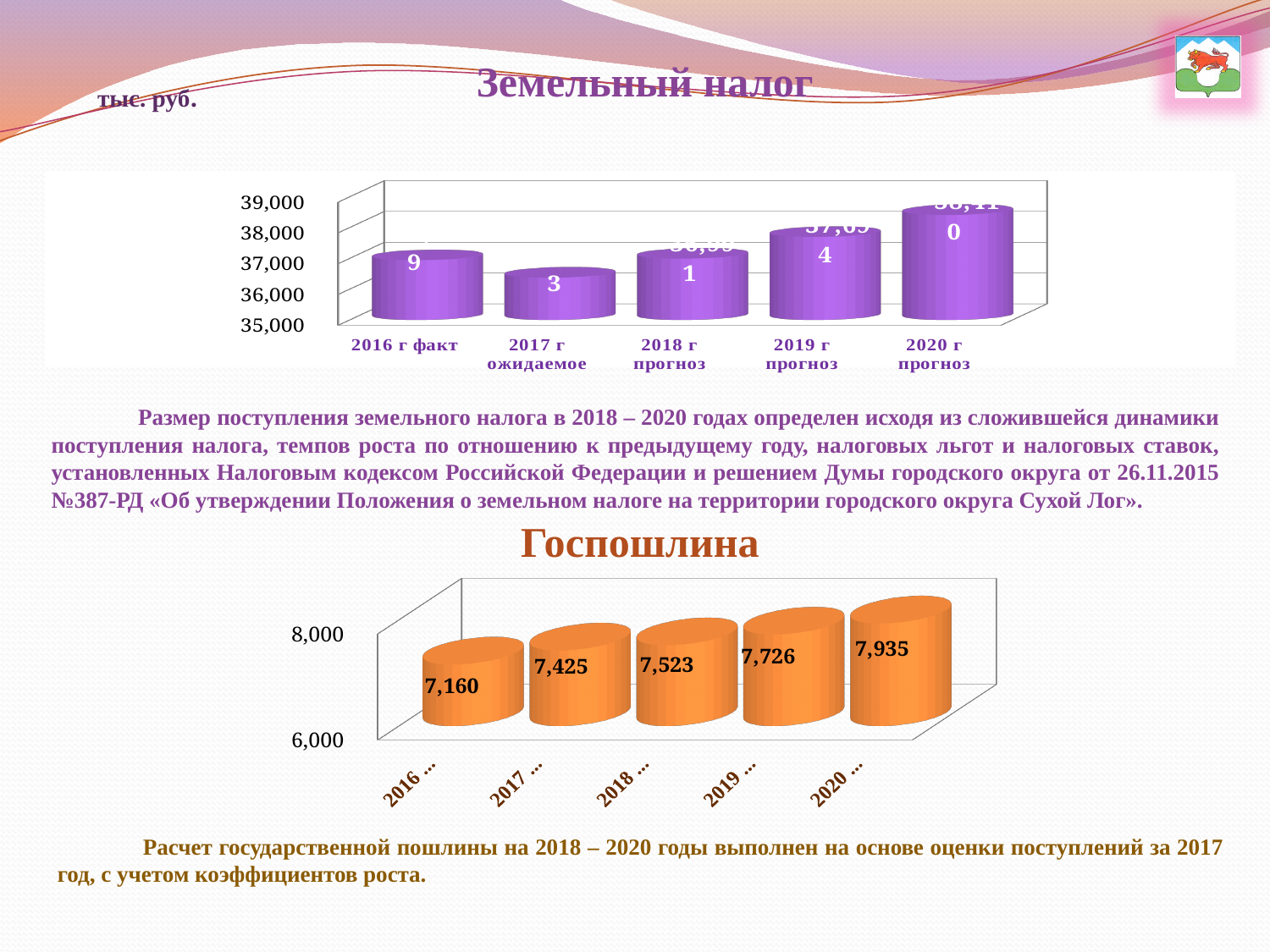
On the Земельный налог chart, which category has the lowest value? 2017 г ожидаемое On the Земельный налог chart, how many categories are shown on the x axis? 5 On the Земельный налог chart, is the value for 2017 г ожидаемое greater or less than 37,000? less On the Земельный налог chart, which category has the highest value? 2020 г прогноз On the Госпошлина chart, what is the difference between the 2020 value and the 2016 value? 775 On the Госпошлина chart, what is the value for 2019? 7,726 On the Госпошлина chart, do the values rise or fall from 2016 to 2020? rise On the Госпошлина chart, what is the value for 2016? 7,160 On the Госпошлина chart, what is the value for 2020? 7,935 On the Госпошлина chart, which year has the lowest value? 2016 On the Госпошлина chart, which year has the highest value? 2020 What kind of chart is the Госпошлина chart? bar chart